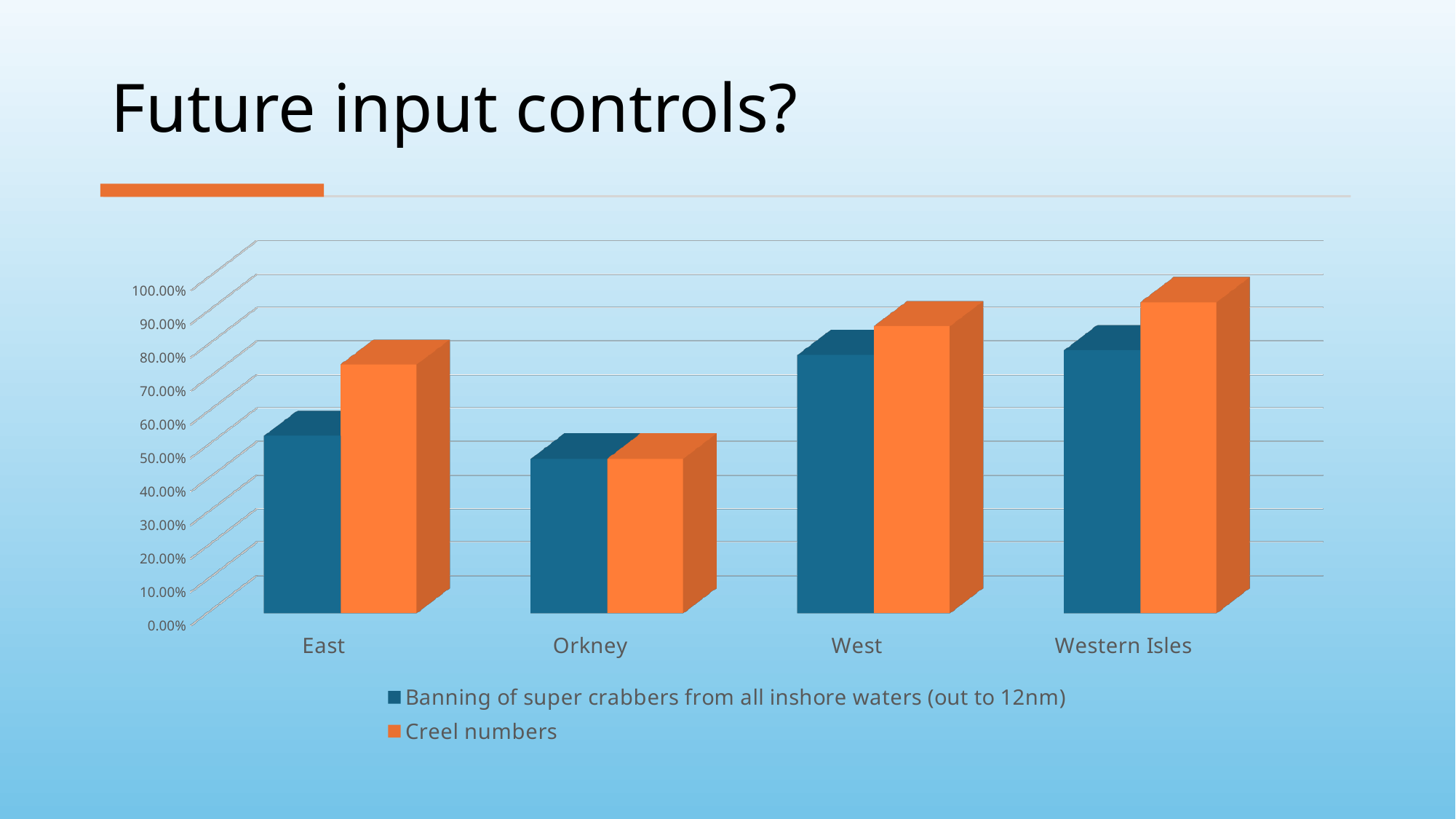
Is the value for Banning of super crabbers from all inshore waters (out to 12nm) at Orkney greater or less than 60.00%? less How many categories are shown on the x axis of the chart? 4 For East, which is larger: Creel numbers or Banning of super crabbers from all inshore waters (out to 12nm)? Creel numbers What kind of chart is shown on the slide? Bar chart How many series does the chart legend list? 2 Is the value for Creel numbers at East greater or less than 70.00%? greater For Western Isles, which is larger: Creel numbers or Banning of super crabbers from all inshore waters (out to 12nm)? Creel numbers Which colour represents Creel numbers in the chart legend? Orange Which category has the lowest value for Creel numbers? Orkney Is the value for Creel numbers at Western Isles greater or less than 90.00%? greater Which category has the lowest value for Banning of super crabbers from all inshore waters (out to 12nm)? Orkney Which category has the highest value for Creel numbers? Western Isles